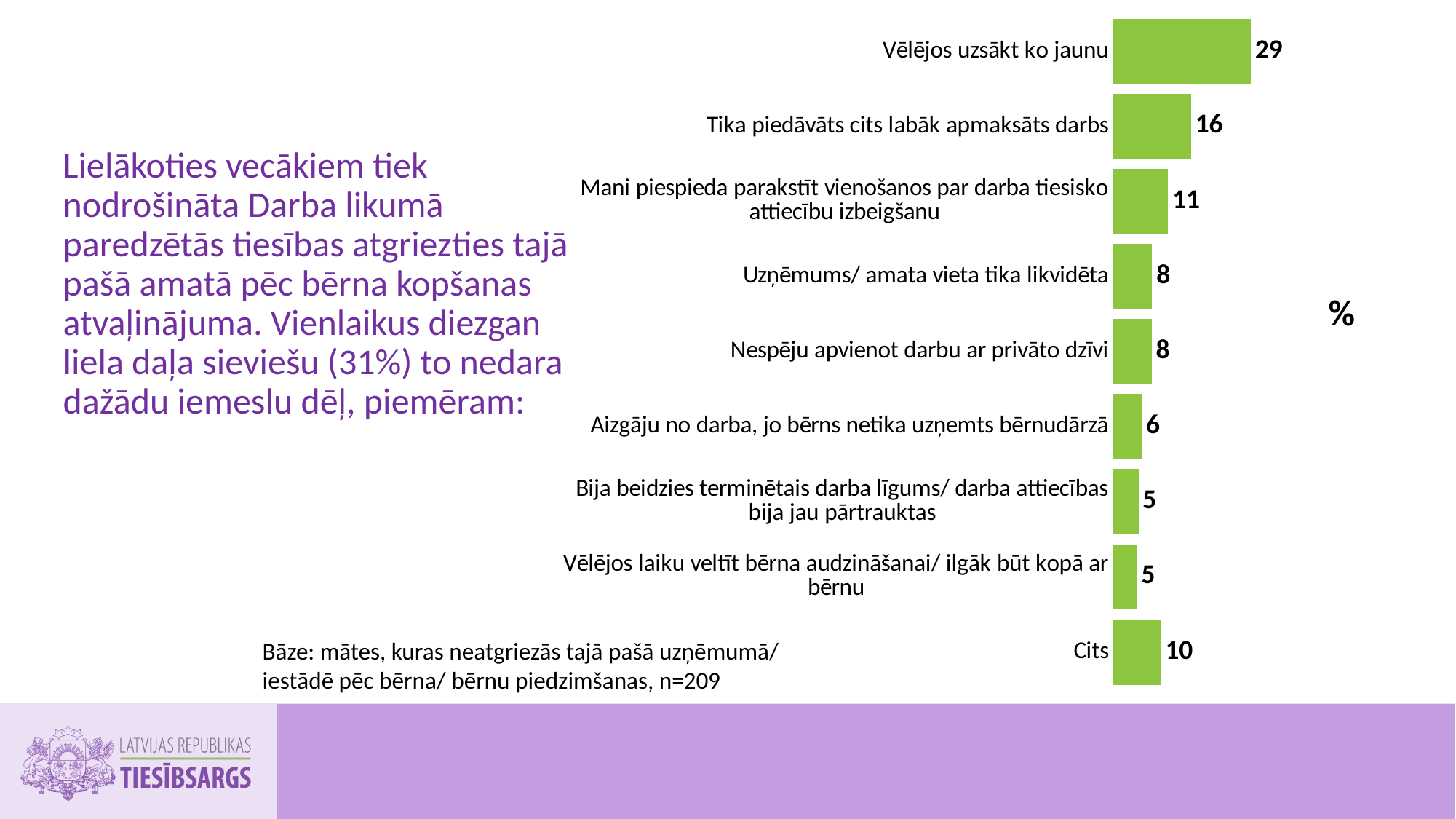
What is the value for "Mani piespieda parakstīt vienošanos par darba tiesisko attiecību izbeigšanu"? 11 How many categories are shown in the chart? 9 What is the difference between the values for "Cits" and "Aizgāju no darba, jo bērns netika uzņemts bērnudārzā"? 4 What is the value for "Vēlējos uzsākt ko jaunu"? 29 Which is larger: the value for "Cits" or the value for "Uzņēmums/ amata vieta tika likvidēta"? Cits What is the value for "Aizgāju no darba, jo bērns netika uzņemts bērnudārzā"? 6 What is the difference between the values for "Vēlējos uzsākt ko jaunu" and "Tika piedāvāts cits labāk apmaksāts darbs"? 13 Which category has the highest value? Vēlējos uzsākt ko jaunu What unit symbol is shown next to the chart? % What is the value for "Cits"? 10 What is the value for "Tika piedāvāts cits labāk apmaksāts darbs"? 16 What kind of chart is shown on the slide? bar chart